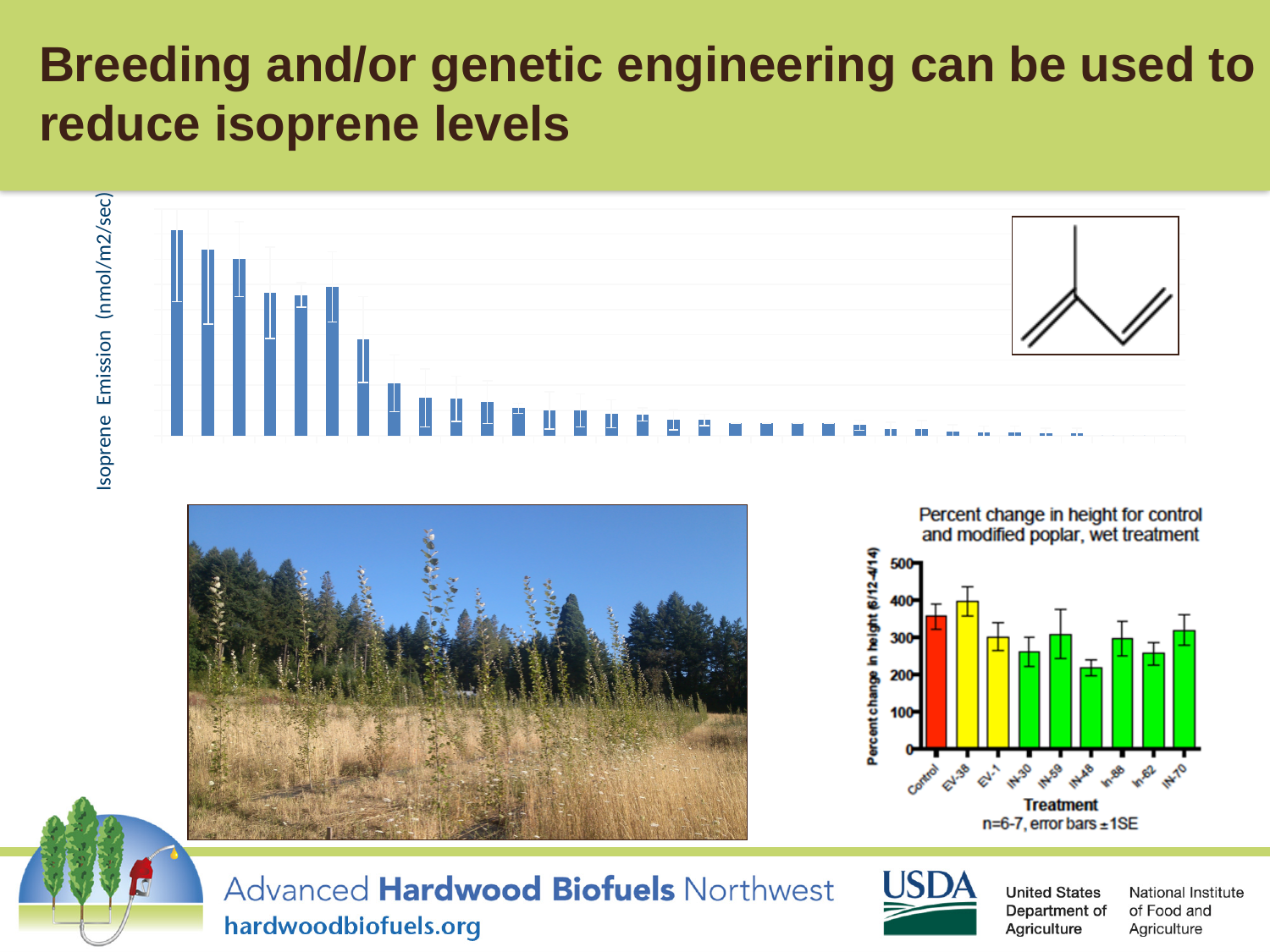
In the 'Percent change in height' chart, is the value for IN-48 greater or less than 300? less In the 'Percent change in height' chart, is the value for Control greater or less than 300? greater In the 'Percent change in height' chart, what is the title of the x axis? Treatment What kind of chart is the 'Percent change in height for control and modified poplar, wet treatment' chart? bar chart In the 'Percent change in height' chart, is the value for IN-30 greater or less than 300? less In the 'Percent change in height' chart, which is larger, the value for EV-38 or the value for IN-48? EV-38 In the top chart, what is the label on the vertical axis? Isoprene Emission (nmol/m2/sec) In the 'Percent change in height' chart, which treatment has the highest percent change in height? EV-38 In the 'Percent change in height' chart, how many treatments are shown on the x axis? 9 In the top chart, do the bar values rise or fall from left to right? fall In the 'Percent change in height' chart, which treatment has the lowest percent change in height? IN-48 What kind of chart is the top chart showing isoprene emission? bar chart